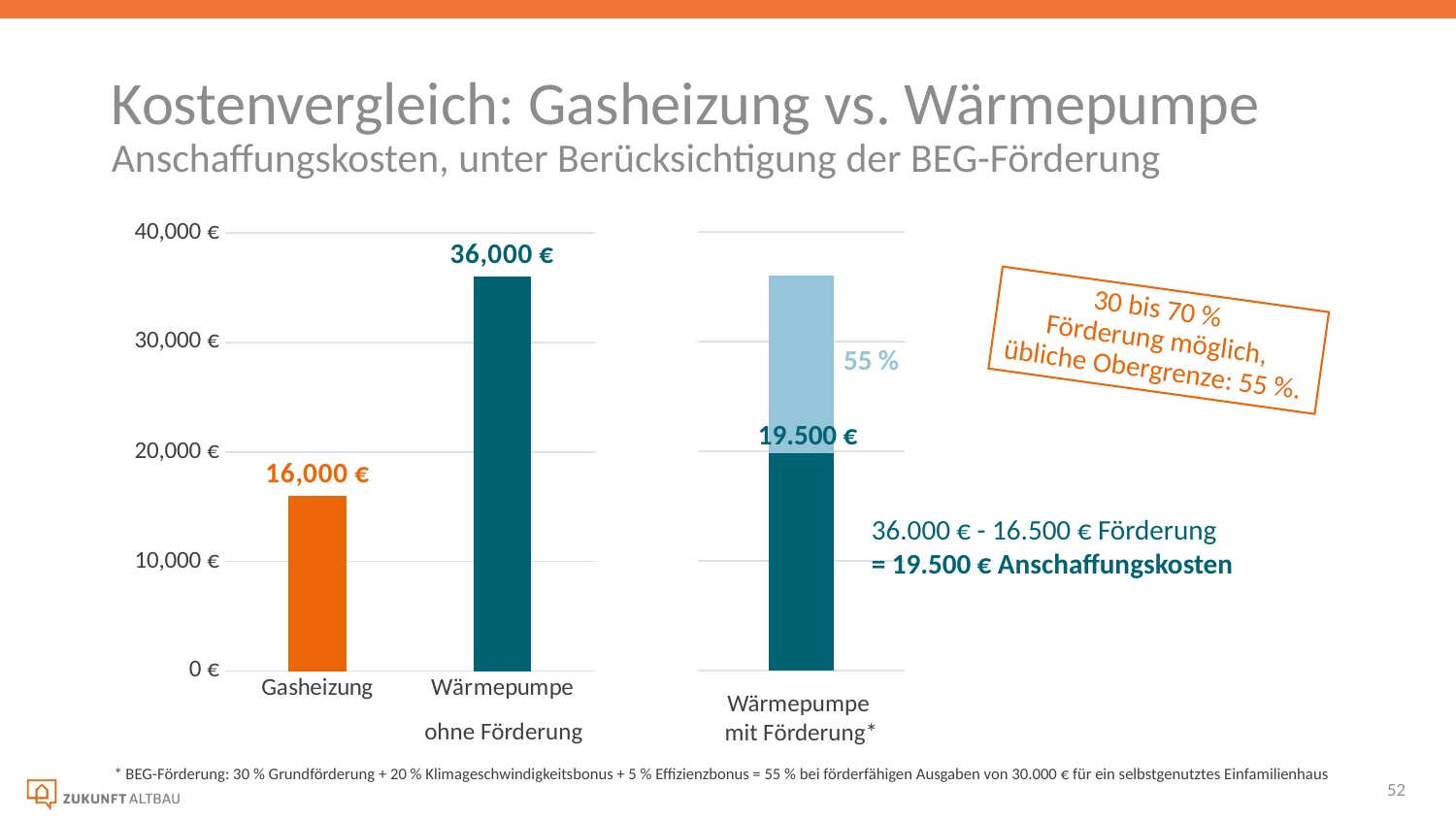
Which is larger, the value for Gasheizung or the value for Wärmepumpe mit Förderung? Wärmepumpe mit Förderung What is the value shown on the dark bar for Wärmepumpe mit Förderung? 19.500 € What kind of chart is shown on the slide? bar chart What percentage label is printed next to the light blue segment of the Wärmepumpe mit Förderung bar? 55 % Which bar has the lowest value? Gasheizung What is the value shown for Wärmepumpe ohne Förderung? 36,000 € Is the value for Gasheizung greater or less than 20,000 €? less What is the value shown for Gasheizung? 16,000 € How many bars are shown in the chart? 3 What is the difference between Wärmepumpe ohne Förderung and Gasheizung? 20,000 € What is the difference between Wärmepumpe ohne Förderung and Wärmepumpe mit Förderung? 16,500 €